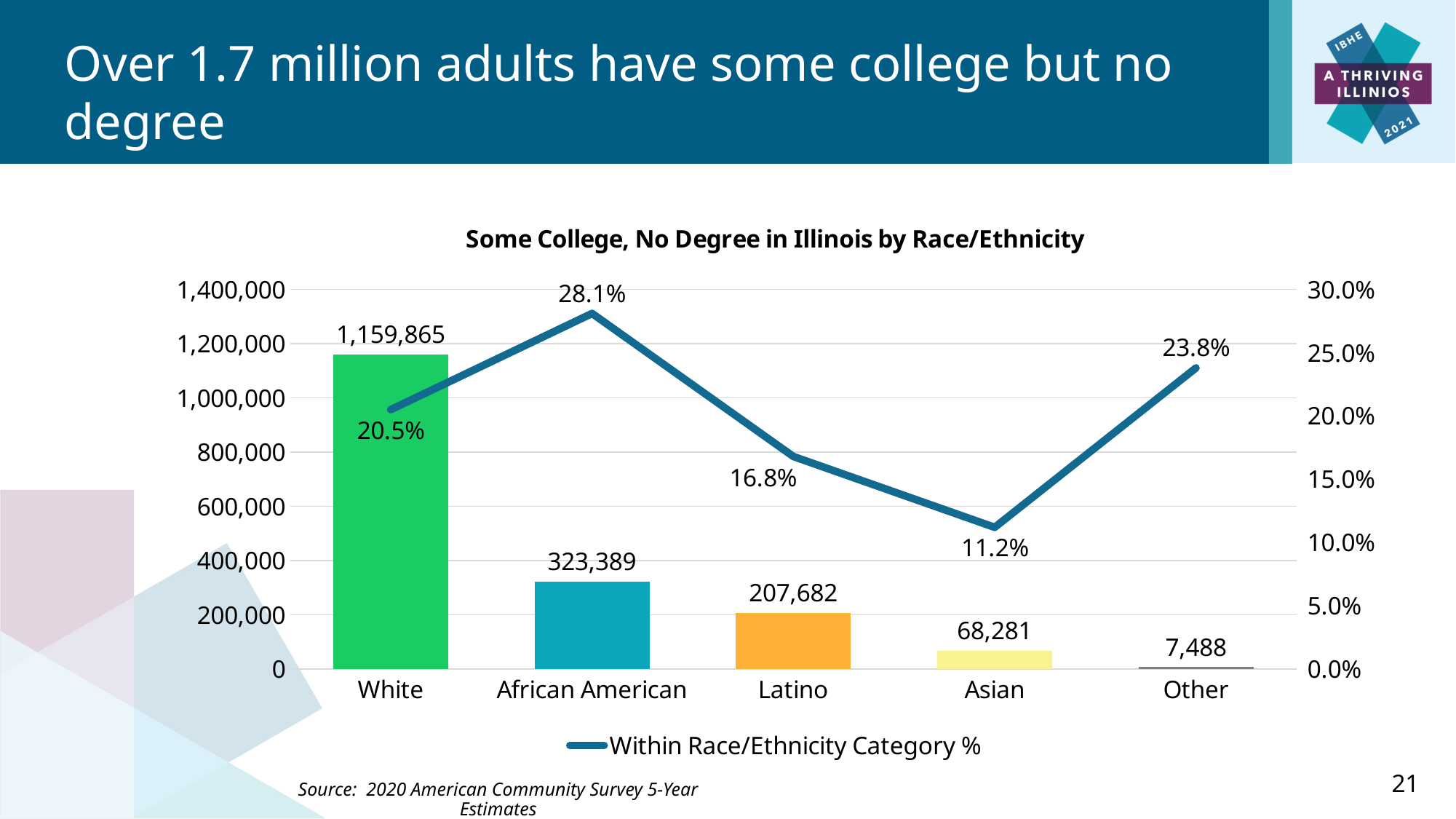
How many series does the legend list? 1 Which race/ethnicity category has the lowest Within Race/Ethnicity Category %? Asian What is the difference between the number of adults for African American and Latino? 115,707 What is the number of adults with some college but no degree for Other? 7,488 Which race/ethnicity category has the highest number of adults with some college but no degree? White Which race/ethnicity category has the highest Within Race/Ethnicity Category %? African American What is the Within Race/Ethnicity Category % value for Asian? 11.2% How many race/ethnicity categories are shown on the x axis? 5 What is the title of the chart? Some College, No Degree in Illinois by Race/Ethnicity What is the number of adults with some college but no degree for African American? 323,389 What kind of chart is shown on the slide? A combined bar and line chart Which has a higher Within Race/Ethnicity Category %, White or Other? Other